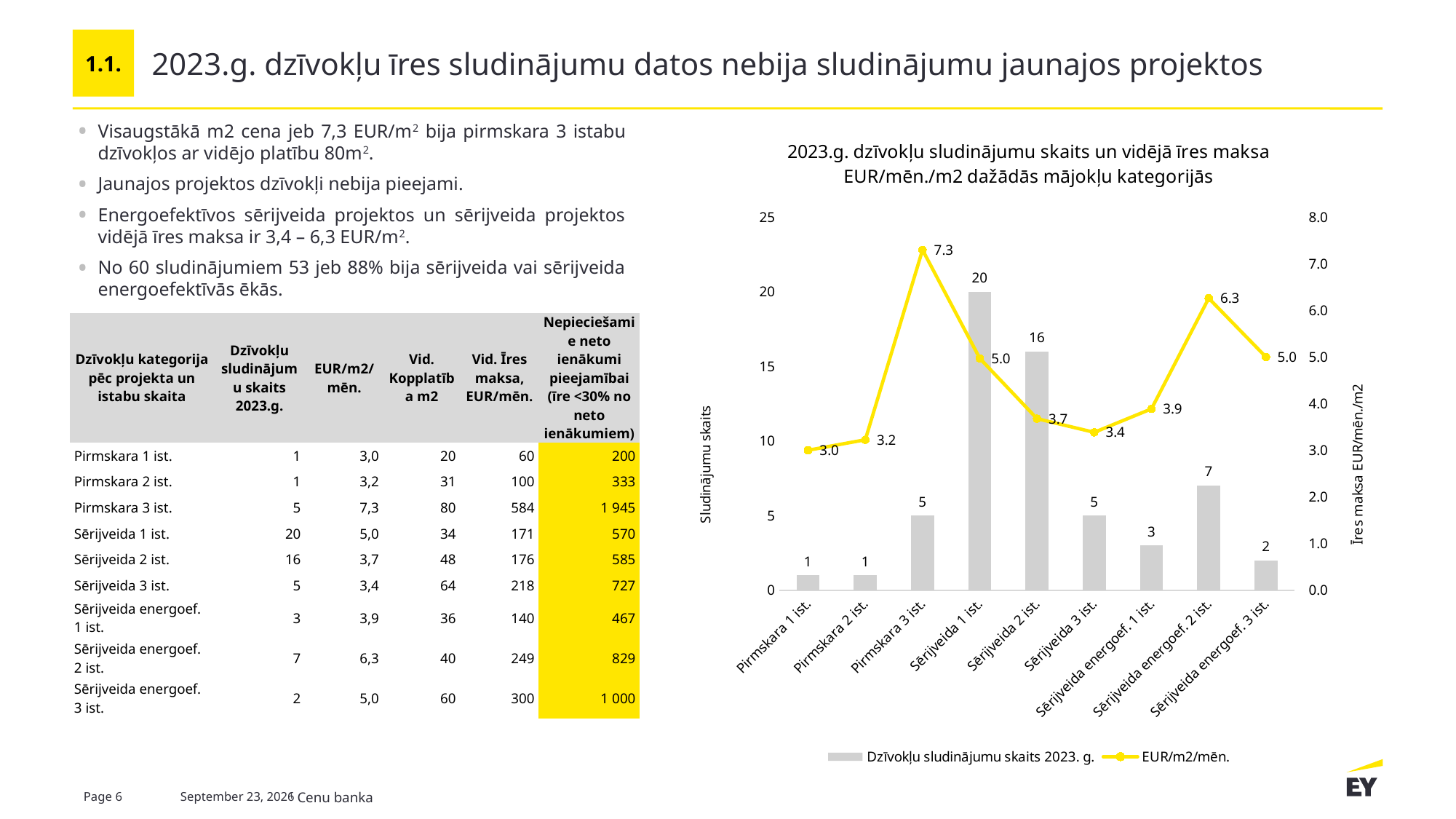
What kind of chart is shown on the slide? Combined bar and line chart How many categories are shown on the x axis of the chart? 9 What is the EUR/m2/mēn. value for Pirmskara 3 ist.? 7.3 Which category has the lowest EUR/m2/mēn. value on the line? Pirmskara 1 ist. How many series does the chart legend list? 2 What is the number of listings (Dzīvokļu sludinājumu skaits 2023. g.) for Sērijveida 1 ist.? 20 What is the number of listings for Sērijveida energoef. 3 ist.? 2 What is the EUR/m2/mēn. value for Sērijveida energoef. 2 ist.? 6.3 What is the difference in number of listings between Sērijveida 1 ist. and Sērijveida 2 ist.? 4 Which has a higher EUR/m2/mēn. value: Sērijveida 2 ist. or Sērijveida energoef. 1 ist.? Sērijveida energoef. 1 ist. What is the label of the right-hand vertical axis of the chart? Īres maksa EUR/mēn./m2 Which category has the highest number of listings (bars)? Sērijveida 1 ist.